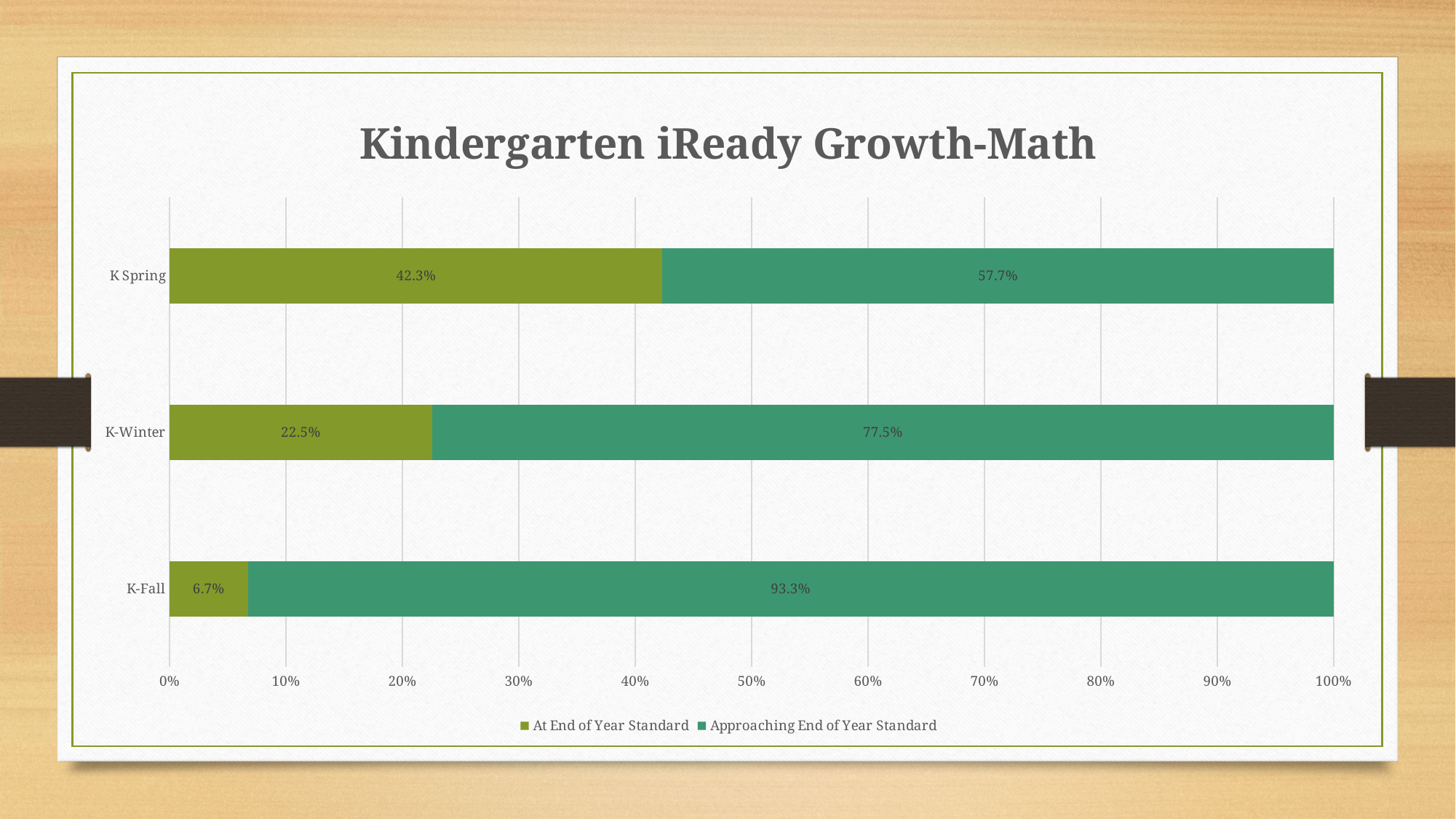
Which category has the highest value for At End of Year Standard? K Spring What is the difference between the At End of Year Standard values for K Spring and K-Winter? 19.8% How many categories are shown on the chart? 3 What kind of chart is shown on the slide? Stacked bar chart What is the value for At End of Year Standard for K-Fall? 6.7% What is the title of the chart? Kindergarten iReady Growth-Math Which is larger: the At End of Year Standard value for K-Winter or for K-Fall? K-Winter What is the value for Approaching End of Year Standard for K-Winter? 77.5% How many series does the legend list? 2 Is the Approaching End of Year Standard value for K-Fall greater or less than 90%? greater Which category has the lowest value for Approaching End of Year Standard? K Spring What is the value for At End of Year Standard for K Spring? 42.3%